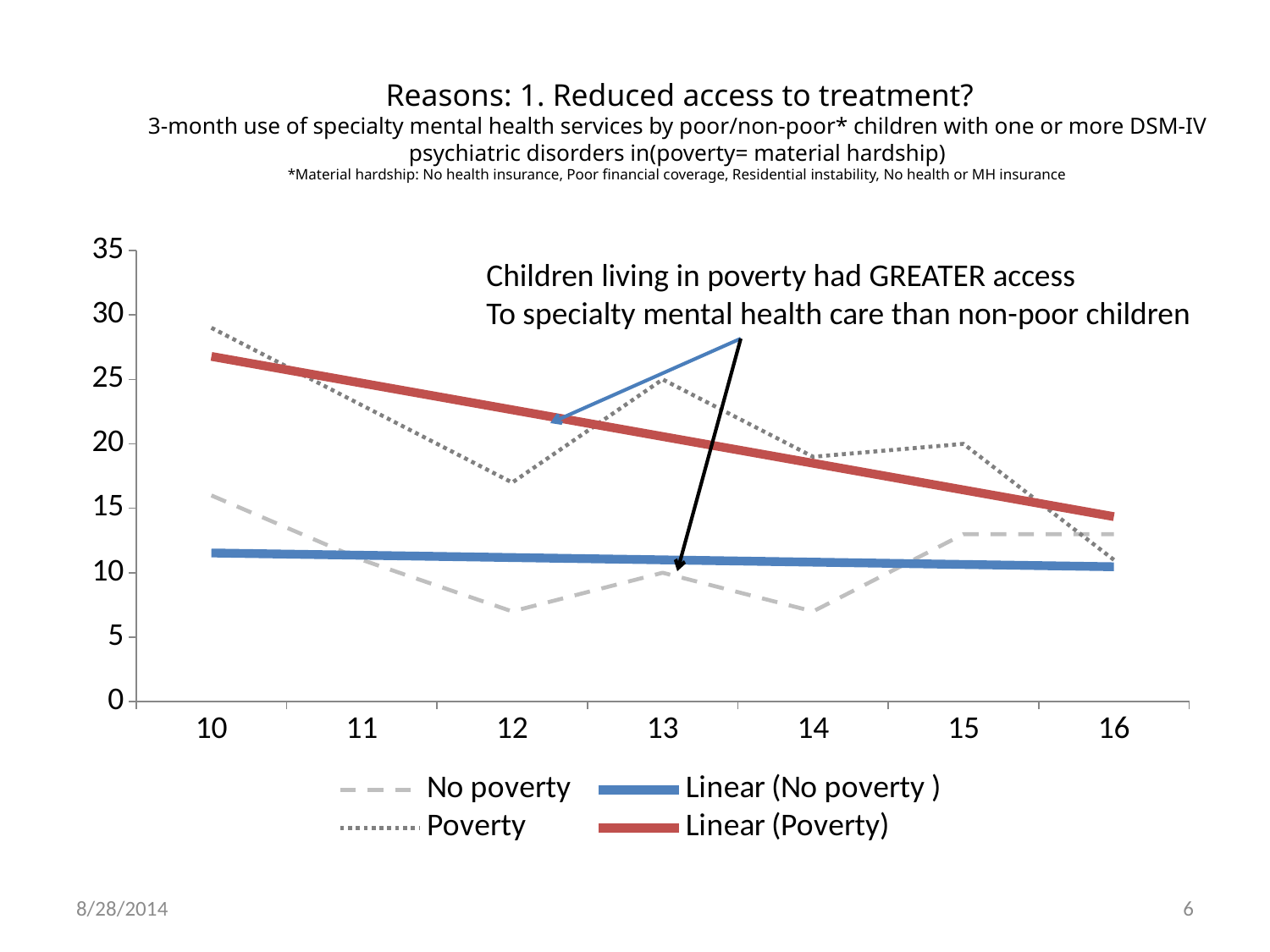
What kind of chart is shown on the slide? Line chart At age 12, which series has the larger value, Poverty or No poverty? Poverty How many age points are plotted along the x axis? 7 Does the Linear (Poverty) trend line rise or fall from age 10 to age 16? Fall How many series does the legend list? 4 Is the value for the Poverty series at age 12 greater or less than 20? less At which age is the Poverty series lowest? 16 Is the value for the No poverty series at age 12 greater or less than 10? less Is the value for the Poverty series at age 10 greater or less than 25? greater At which age is the Poverty series highest? 10 At which age is the No poverty series highest? 10